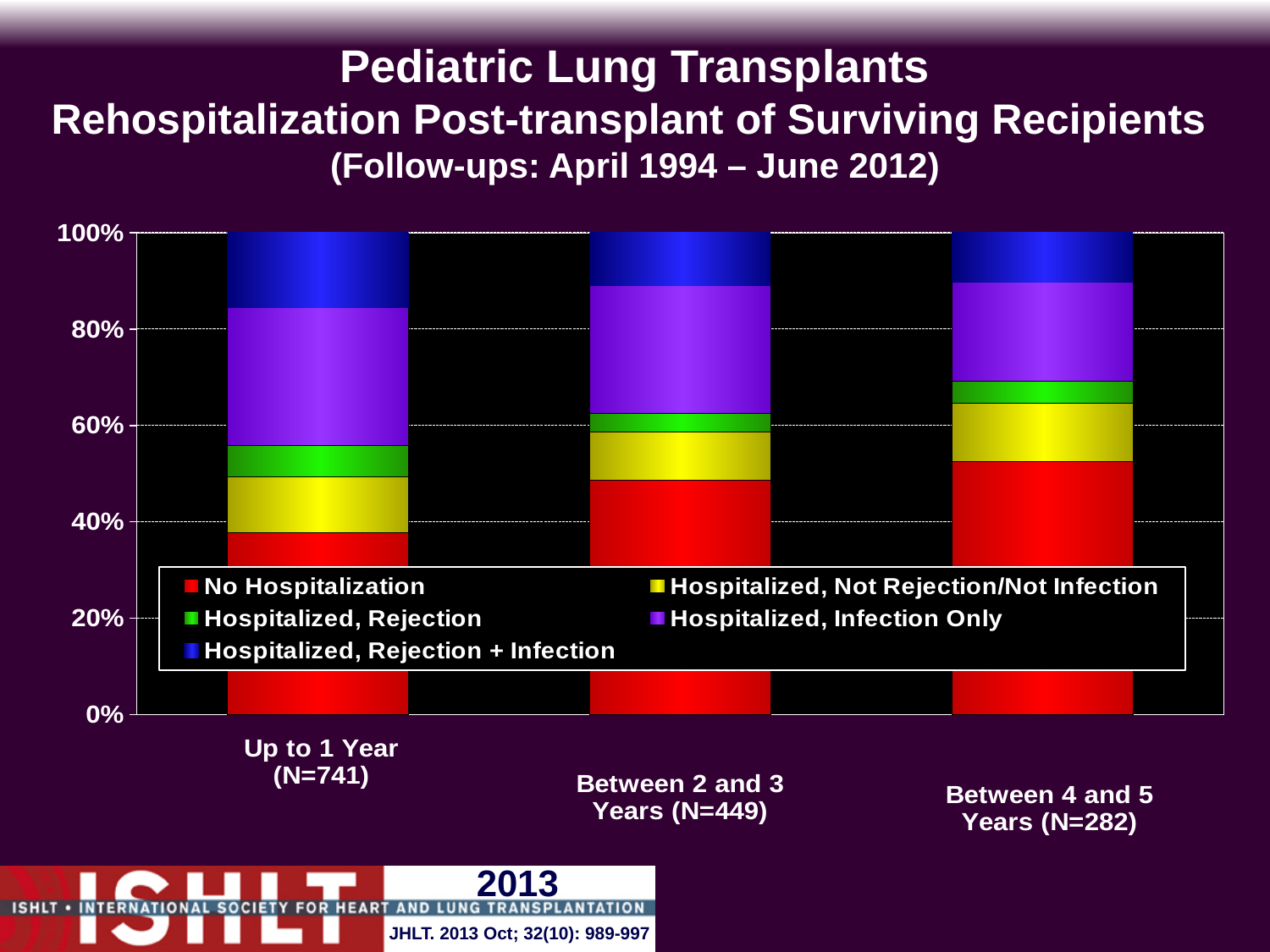
Which colour represents No Hospitalization in the legend? Red Is the No Hospitalization share for Between 4 and 5 Years greater or less than 40%? greater What kind of chart is shown on the slide? Stacked bar chart How many follow-up period categories are plotted on the x axis? 3 Which follow-up period has the smallest No Hospitalization share? Up to 1 Year Is the No Hospitalization share for Between 2 and 3 Years greater or less than 60%? less Does the No Hospitalization share rise or fall from Up to 1 Year to Between 4 and 5 Years? Rise Which is larger: the No Hospitalization share for Up to 1 Year or for Between 4 and 5 Years? Between 4 and 5 Years Is the No Hospitalization share for Up to 1 Year greater or less than 40%? less What is the N shown for the Up to 1 Year category? 741 What is the total of each stacked bar? 100% How many series does the legend list? 5